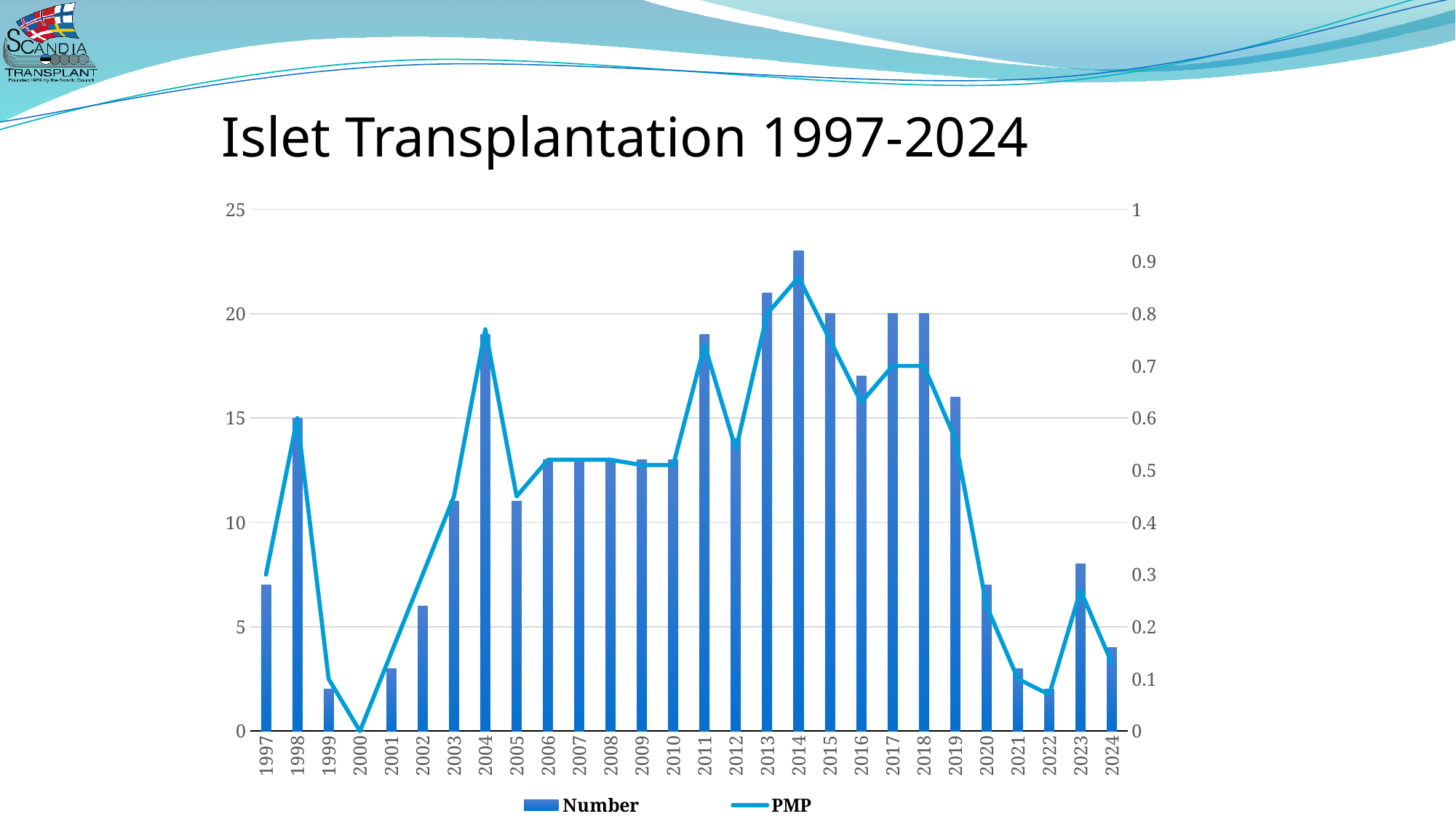
What is the Number value for 2015? 20 How many series does the legend list? 2 What kind of chart is shown on the slide? Combined bar and line chart How many years are shown on the x axis? 28 Which year has the larger Number value, 2011 or 2012? 2011 What is the Number value for 1998? 15 Do the Number values rise or fall from 2019 to 2022? fall Is the PMP value for 2014 greater or less than 0.8? greater Which year has the lowest Number value? 2000 Which year has the highest Number value? 2014 Is the Number value for 2014 greater or less than 20? greater Is the Number value for 1999 greater or less than 5? less